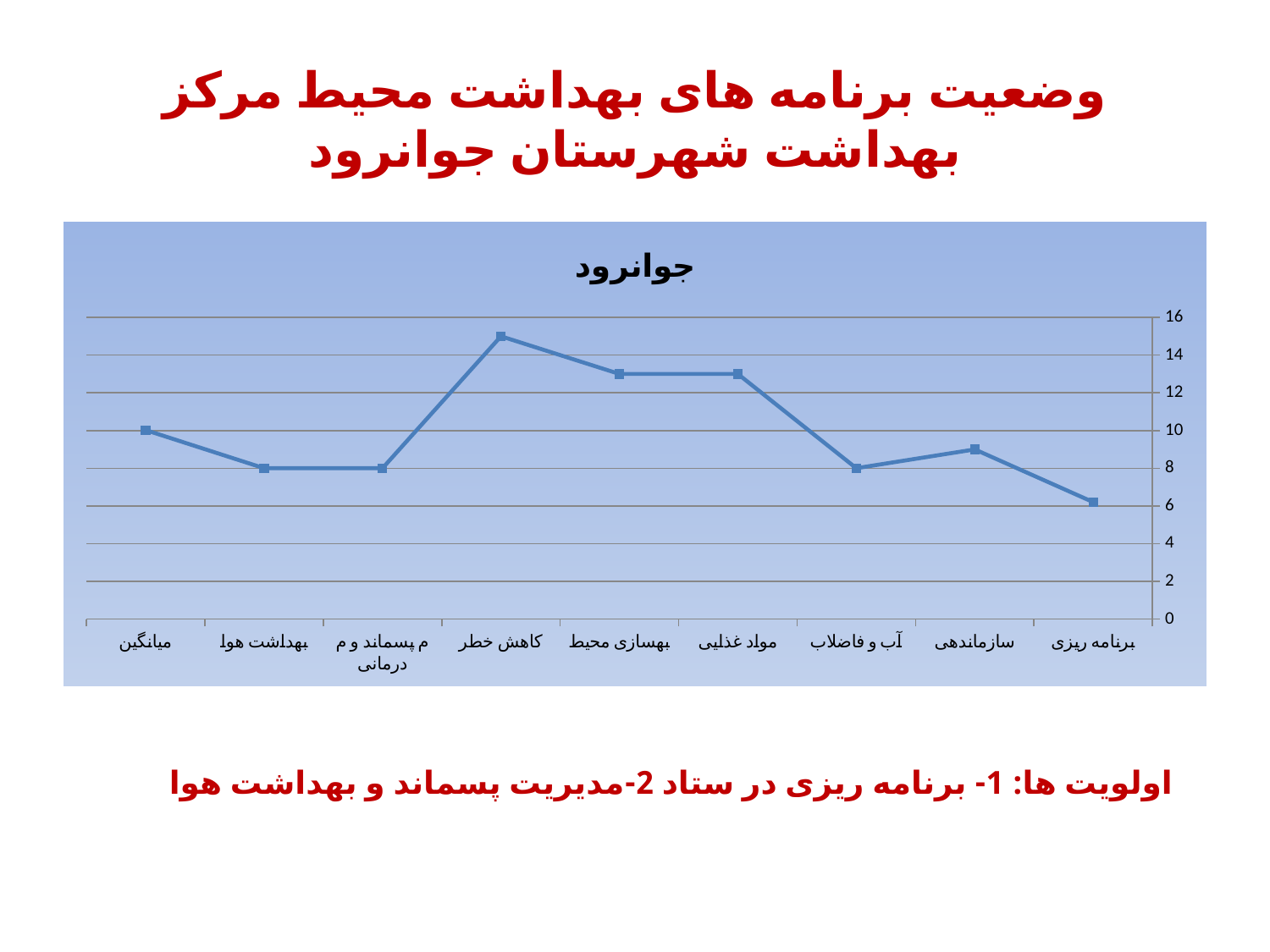
Which category has the highest value? کاهش خطر What is the value for آب و فاضلاب? 8 Is the value for برنامه ریزی greater or less than 8? less How many categories are plotted along the x axis? 9 What is the value for بهداشت هوا? 8 What is the title shown inside the chart area? جوانرود What type of chart is shown on the slide? line chart Which category has the lowest value? برنامه ریزی Is the value for کاهش خطر greater or less than 14? greater Which is larger, the value for کاهش خطر or the value for مواد غذایی? کاهش خطر